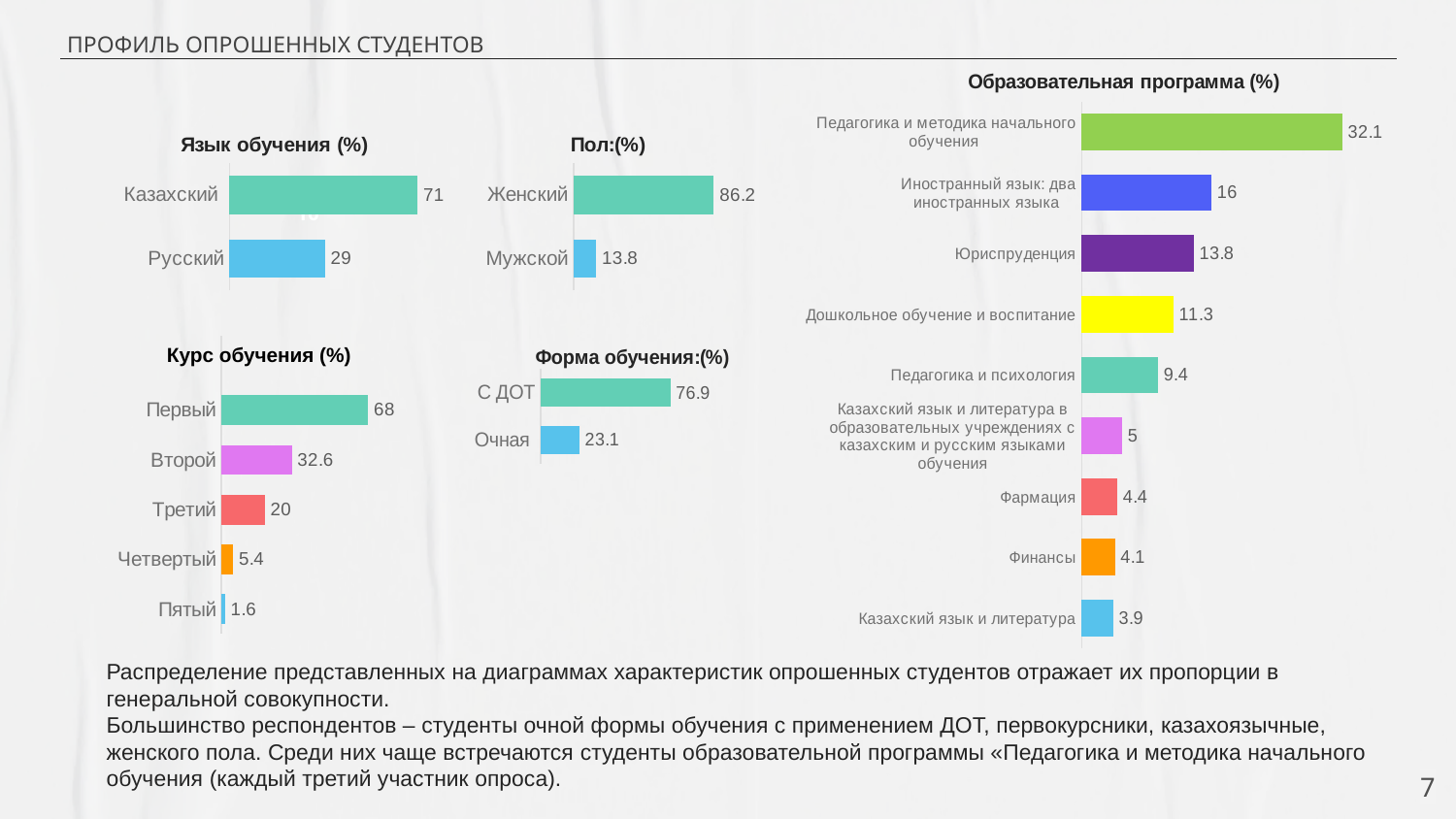
In the 'Форма обучения:(%)' chart, what is the difference between С ДОТ and Очная? 53.8 In the 'Курс обучения (%)' chart, which course has the highest value? Первый In the 'Курс обучения (%)' chart, how many categories are shown? 5 In the 'Язык обучения (%)' chart, what is the value for Казахский? 71 In the 'Образовательная программа (%)' chart, which program has the lowest value? Казахский язык и литература In the 'Пол:(%)' chart, what is the value for Мужской? 13.8 In the 'Образовательная программа (%)' chart, how many programs are listed? 9 In the 'Образовательная программа (%)' chart, which is larger: Фармация or Финансы? Фармация In the 'Образовательная программа (%)' chart, which program has the highest value? Педагогика и методика начального обучения In the 'Курс обучения (%)' chart, which course has the lowest value? Пятый In the 'Образовательная программа (%)' chart, what is the value for Юриспруденция? 13.8 What type of chart is the 'Пол:(%)' chart? Bar chart